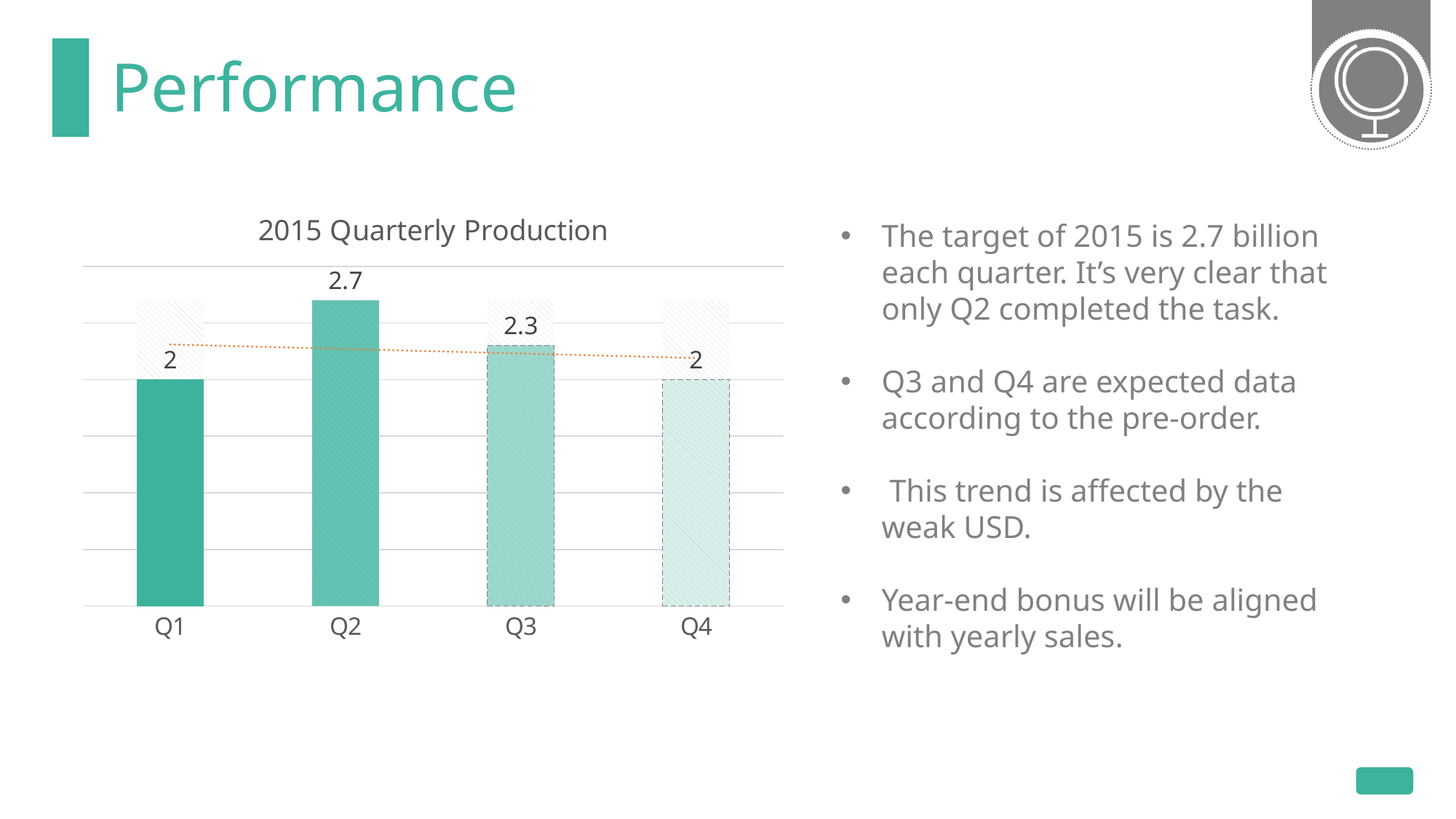
What kind of chart is the 2015 Quarterly Production chart? Bar chart What is the value for Q3 in the 2015 Quarterly Production chart? 2.3 Do the values rise or fall from Q2 to Q4 in the 2015 Quarterly Production chart? Fall What is the title of the chart on the slide? 2015 Quarterly Production What is the value for Q2 in the 2015 Quarterly Production chart? 2.7 What is the difference between the Q2 and Q4 values in the 2015 Quarterly Production chart? 0.7 Which is larger in the 2015 Quarterly Production chart, the value for Q3 or the value for Q4? Q3 Which two quarters in the 2015 Quarterly Production chart have the same value? Q1 and Q4 How many quarters are shown in the 2015 Quarterly Production chart? 4 What is the value for Q1 in the 2015 Quarterly Production chart? 2 Which quarter has the highest value in the 2015 Quarterly Production chart? Q2 What is the difference between the Q2 and Q3 values in the 2015 Quarterly Production chart? 0.4